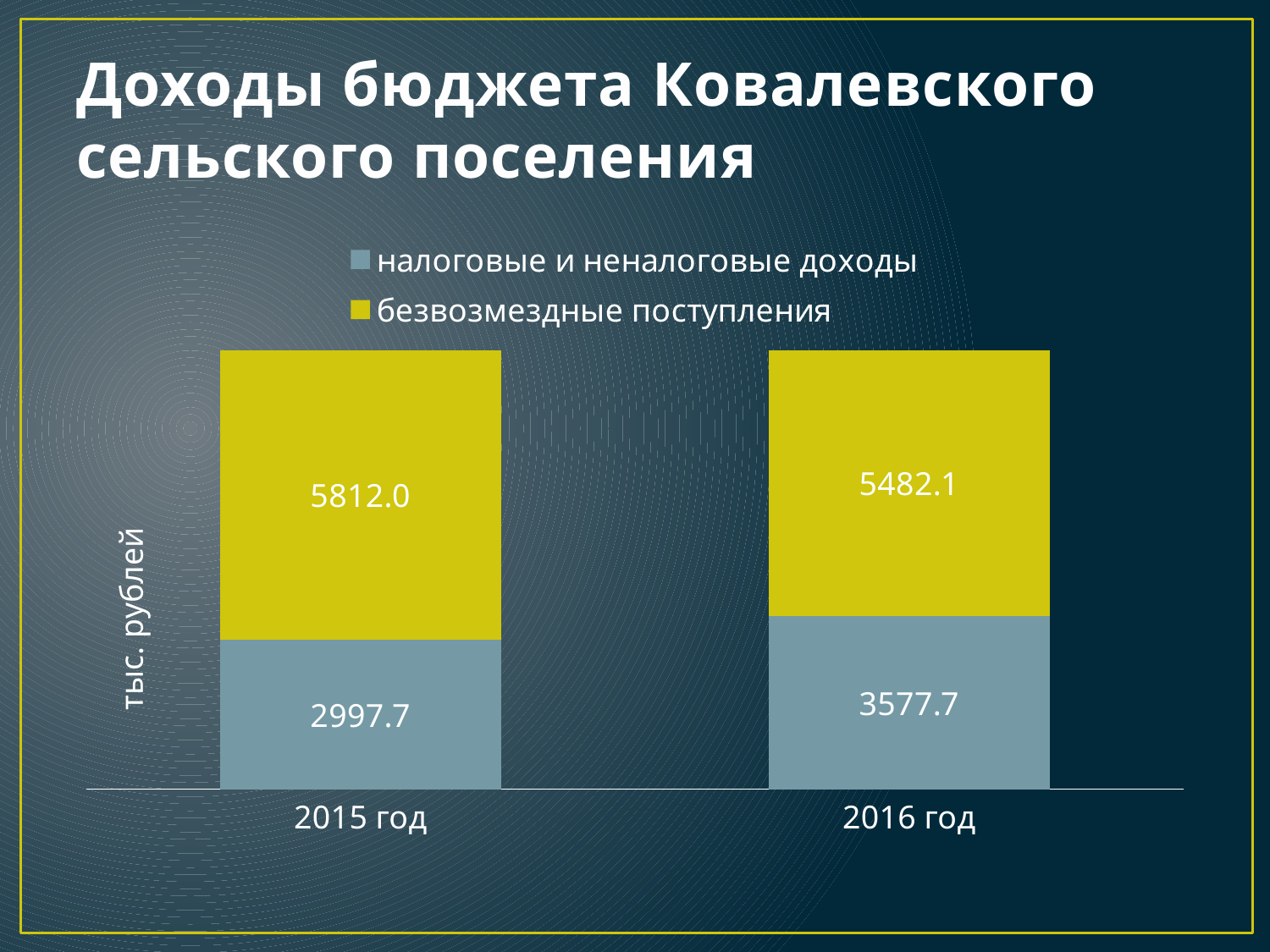
What is the value of налоговые и неналоговые доходы for 2016 год? 3577.7 What is the value of безвозмездные поступления for 2016 год? 5482.1 What is the value of налоговые и неналоговые доходы for 2015 год? 2997.7 What is the difference between налоговые и неналоговые доходы in 2016 год and in 2015 год? 580.0 In which year is безвозмездные поступления highest? 2015 год In which year is налоговые и неналоговые доходы lowest? 2015 год How many series does the legend list? 2 What is the value of безвозмездные поступления for 2015 год? 5812.0 What is the total of the stacked bar for 2016 год? 9059.8 What is the difference between безвозмездные поступления in 2015 год and in 2016 год? 329.9 What is the total of the stacked bar for 2015 год? 8809.7 Which is larger in 2016 год: налоговые и неналоговые доходы or безвозмездные поступления? безвозмездные поступления